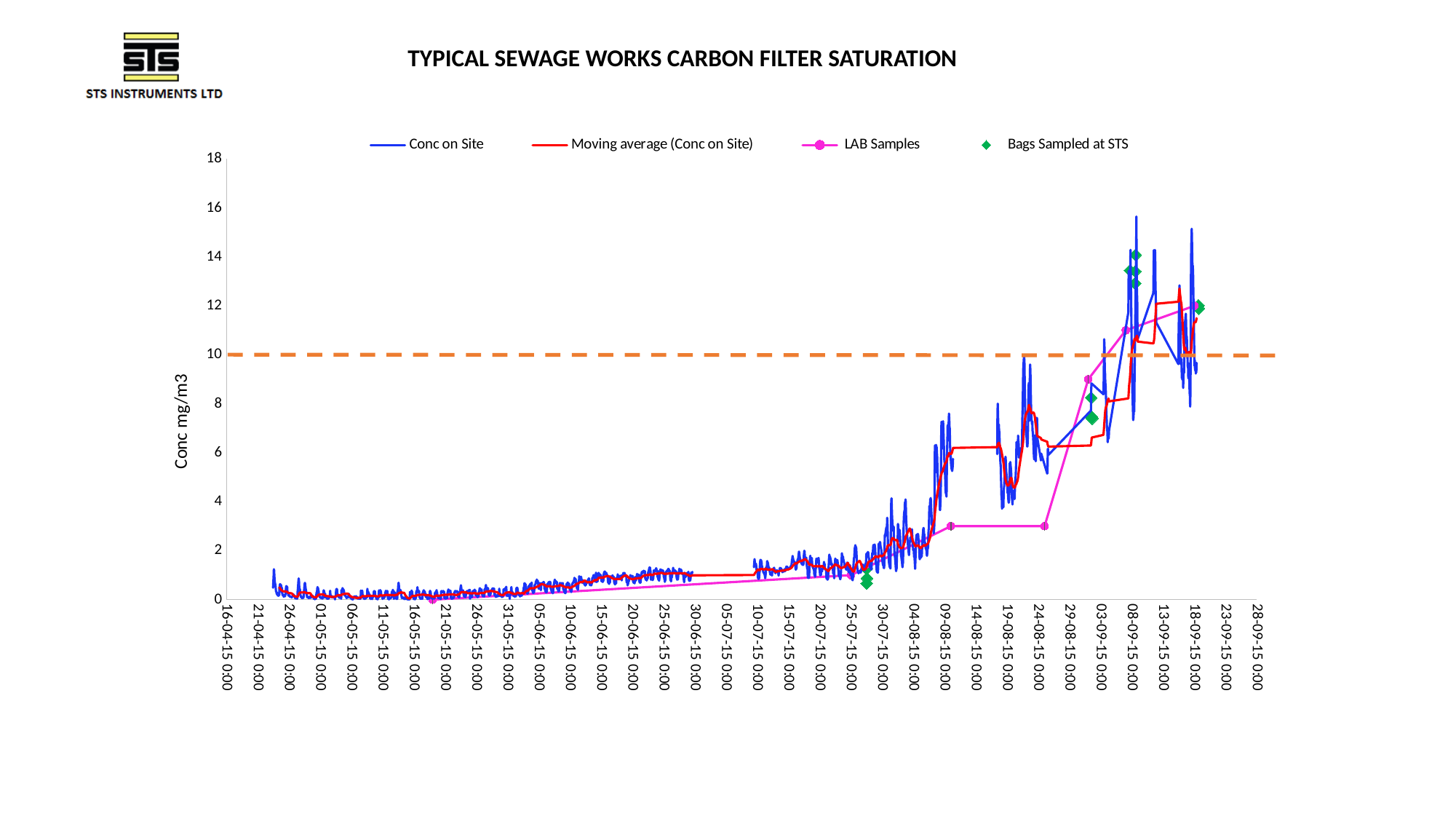
Is the LAB Samples value at 24-08-15 greater or less than 4? less What is the label on the vertical axis? Conc mg/m3 Is the Moving average (Conc on Site) value at 14-08-15 greater or less than 4? greater Is the LAB Samples value at 08-09-15 greater or less than 10? greater Which is larger, the LAB Samples value at 29-08-15 or at 24-08-15? 29-08-15 Overall, do the Conc on Site values rise or fall from April to September along the x axis? rise What is the title of the chart? TYPICAL SEWAGE WORKS CARBON FILTER SATURATION What kind of chart is shown on the slide? line chart How many series does the legend list? 4